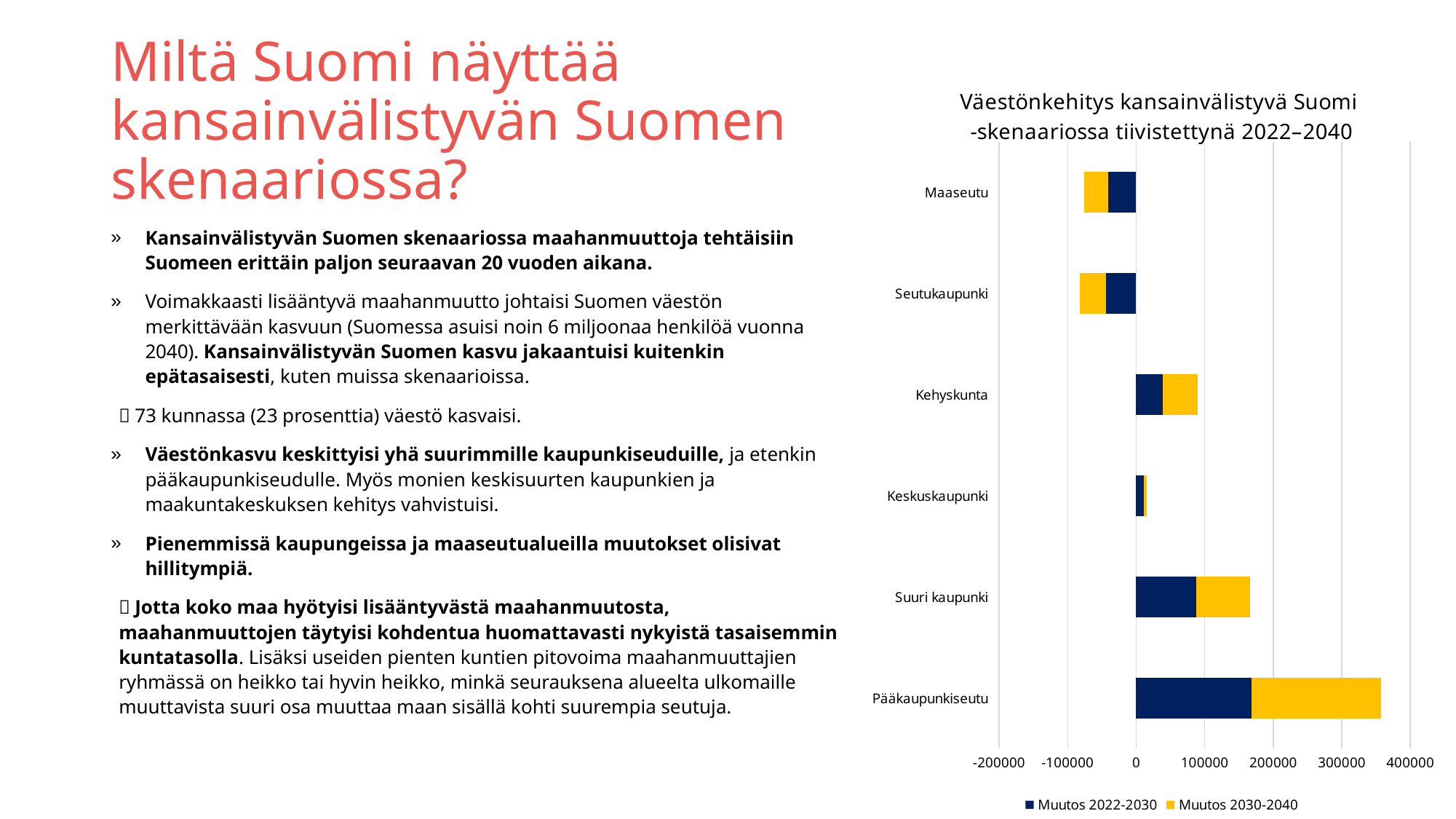
Is the Muutos 2022-2030 value for Suuri kaupunki greater or less than 100000? less How many categories are shown on the chart's vertical axis? 6 What is the title of the chart? Väestönkehitys kansainvälistyvä Suomi -skenaariossa tiivistettynä 2022–2040 Which has the larger total population change, Keskuskaupunki or Pääkaupunkiseutu? Pääkaupunkiseutu Is the total value for Kehyskunta greater or less than 100000? less Which has the larger total population change, Suuri kaupunki or Kehyskunta? Suuri kaupunki How many series does the chart's legend list? 2 Is the total value for Maaseutu greater or less than 0? less Which category has the largest total population change in the chart? Pääkaupunkiseutu Which series is shown in yellow in the chart? Muutos 2030-2040 What kind of chart is shown on the slide? bar chart